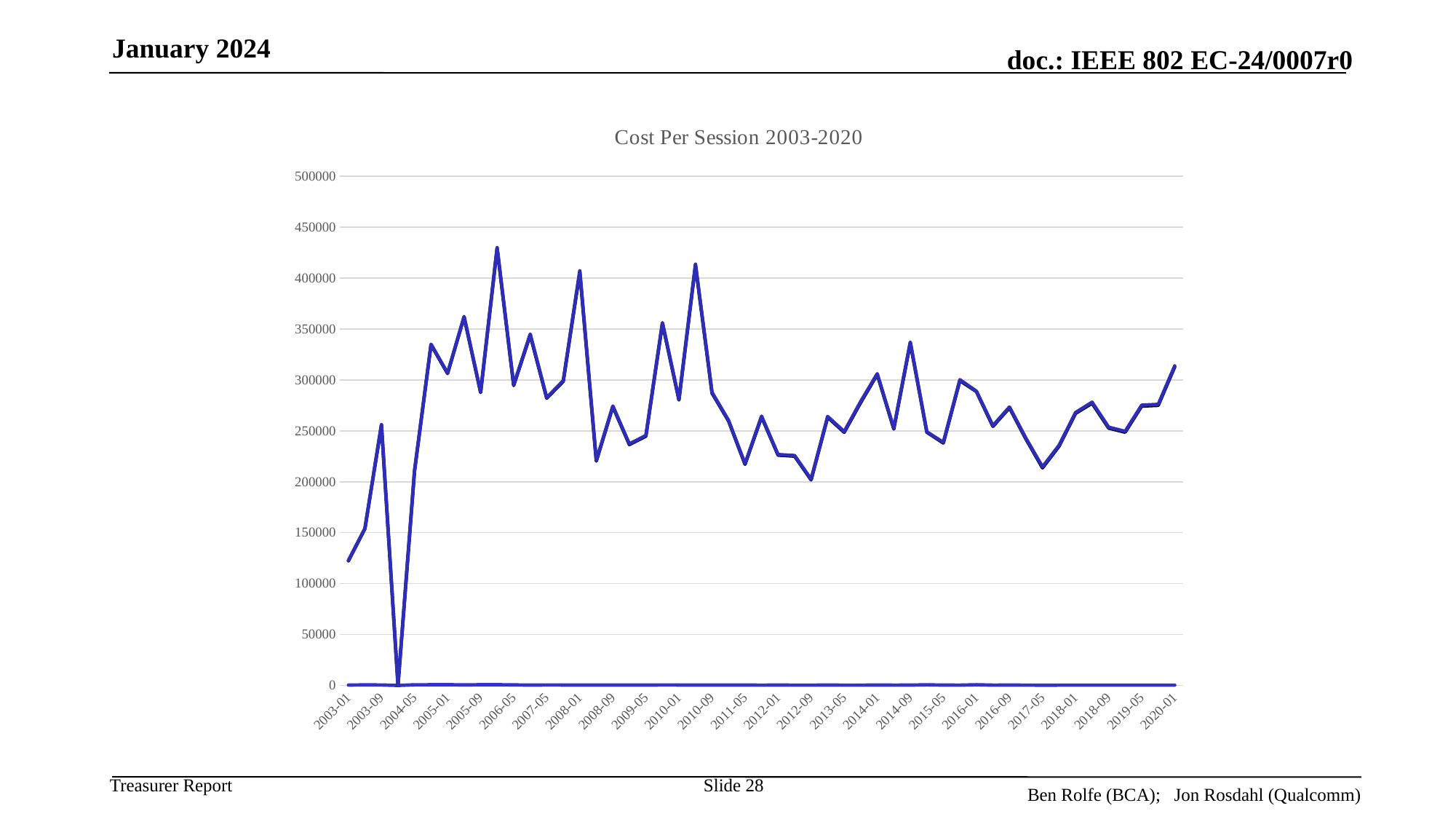
What is the title of the chart? Cost Per Session 2003-2020 What is the lowest value the line drops to? 0 What is the highest value shown on the y axis? 500000 Is the value for 2003-01 greater or less than 150000? less Is the value for 2020-01 greater or less than 300000? greater Does the line rise or fall between 2003-01 and 2003-09? rise Is the value for 2012-09 greater or less than 250000? less Which is larger, the value for 2020-01 or the value for 2003-01? 2020-01 Does the line generally rise or fall between 2010-09 and 2012-09? fall What kind of chart is shown on the slide? line chart